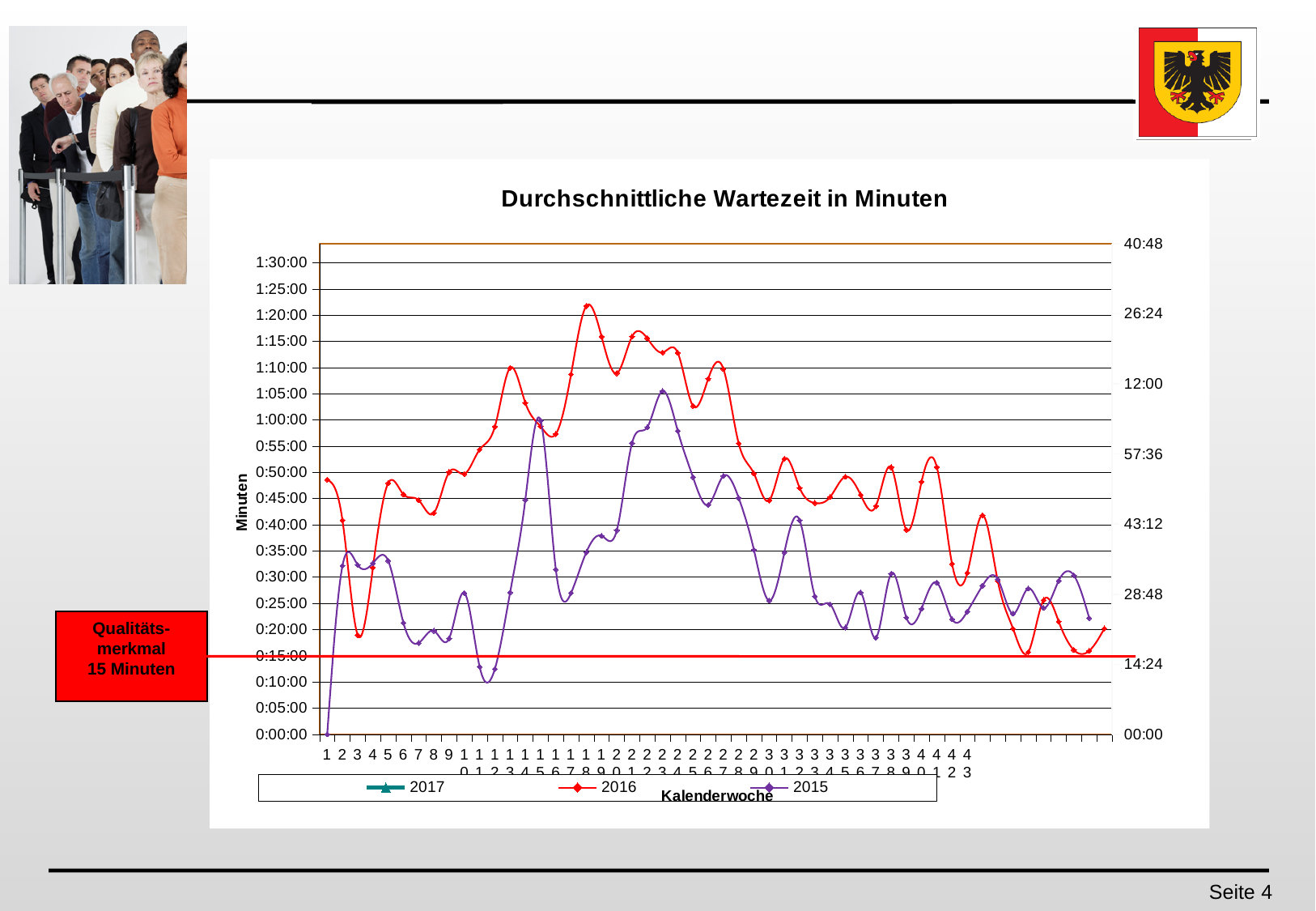
In which Kalenderwoche does the 2016 series reach its highest value? 18 In Kalenderwoche 3, which series has the larger value, 2016 or 2015? 2015 Is the value for the 2016 series in Kalenderwoche 18 greater or less than 1:15:00? greater In which Kalenderwoche does the 2015 series reach its highest value? 23 What is the value for the 2015 series in Kalenderwoche 1? 0:00:00 In which Kalenderwoche does the 2015 series have its lowest value? 1 What is the label of the x axis? Kalenderwoche What is the title of the chart? Durchschnittliche Wartezeit in Minuten Does the 2016 series rise or fall overall from Kalenderwoche 18 to Kalenderwoche 43? fall What kind of chart is shown on the slide? line chart Is the value for the 2015 series in Kalenderwoche 12 greater or less than 0:15:00? less How many series does the legend list? 3